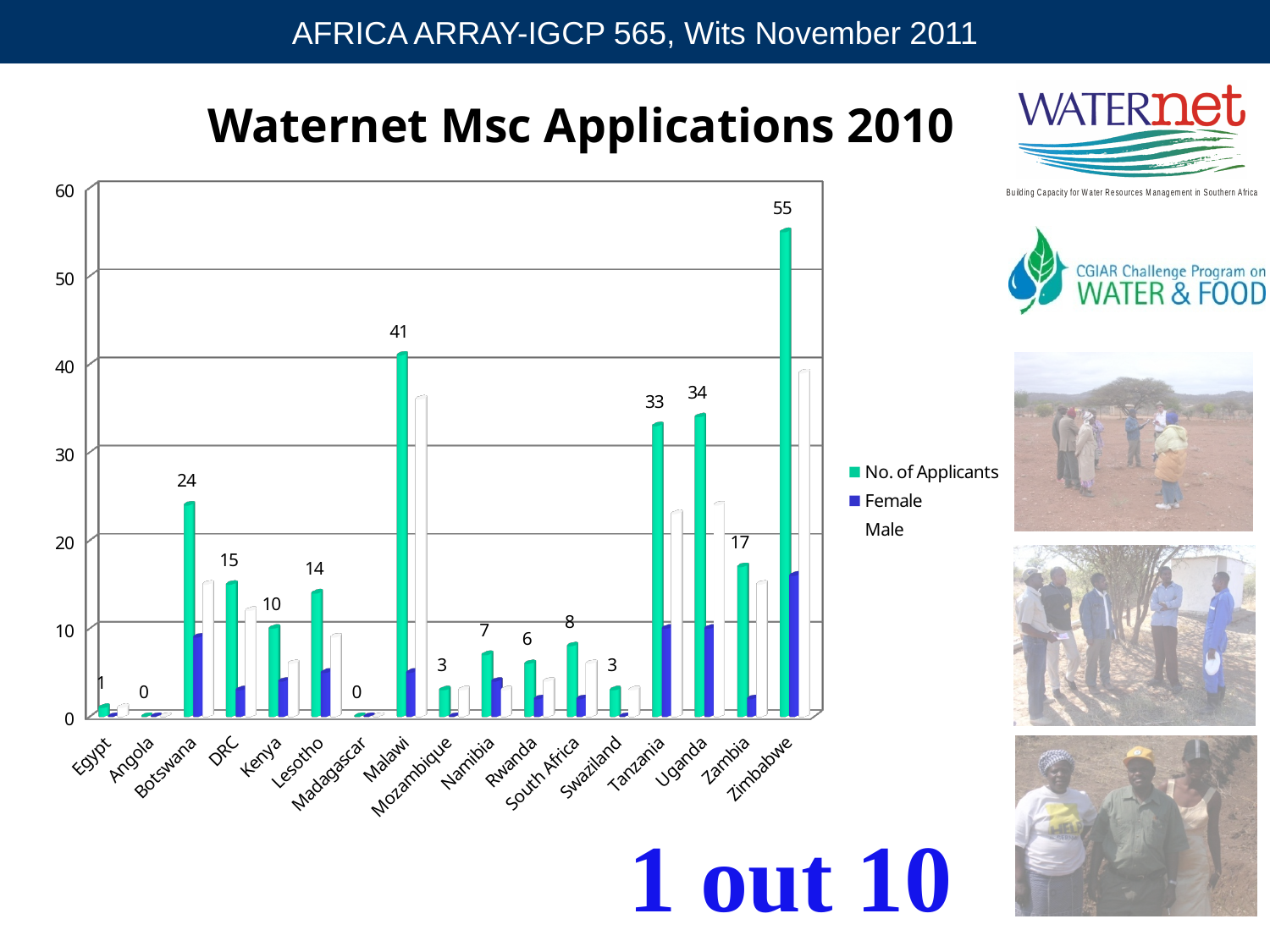
How many series does the legend list? 3 What is the number of applicants for Botswana? 24 Which has more applicants, Lesotho or DRC? DRC What kind of chart is shown on the slide? bar chart What is the number of applicants for Malawi? 41 How many countries are shown on the x axis? 17 Is the Male value for Malawi greater or less than 30? greater What is the number of applicants for Zimbabwe? 55 What is the title of the chart? Waternet Msc Applications 2010 Which country has the highest number of applicants? Zimbabwe What is the difference in number of applicants between Uganda and Tanzania? 1 Is the Female value for Zimbabwe greater or less than 10? greater